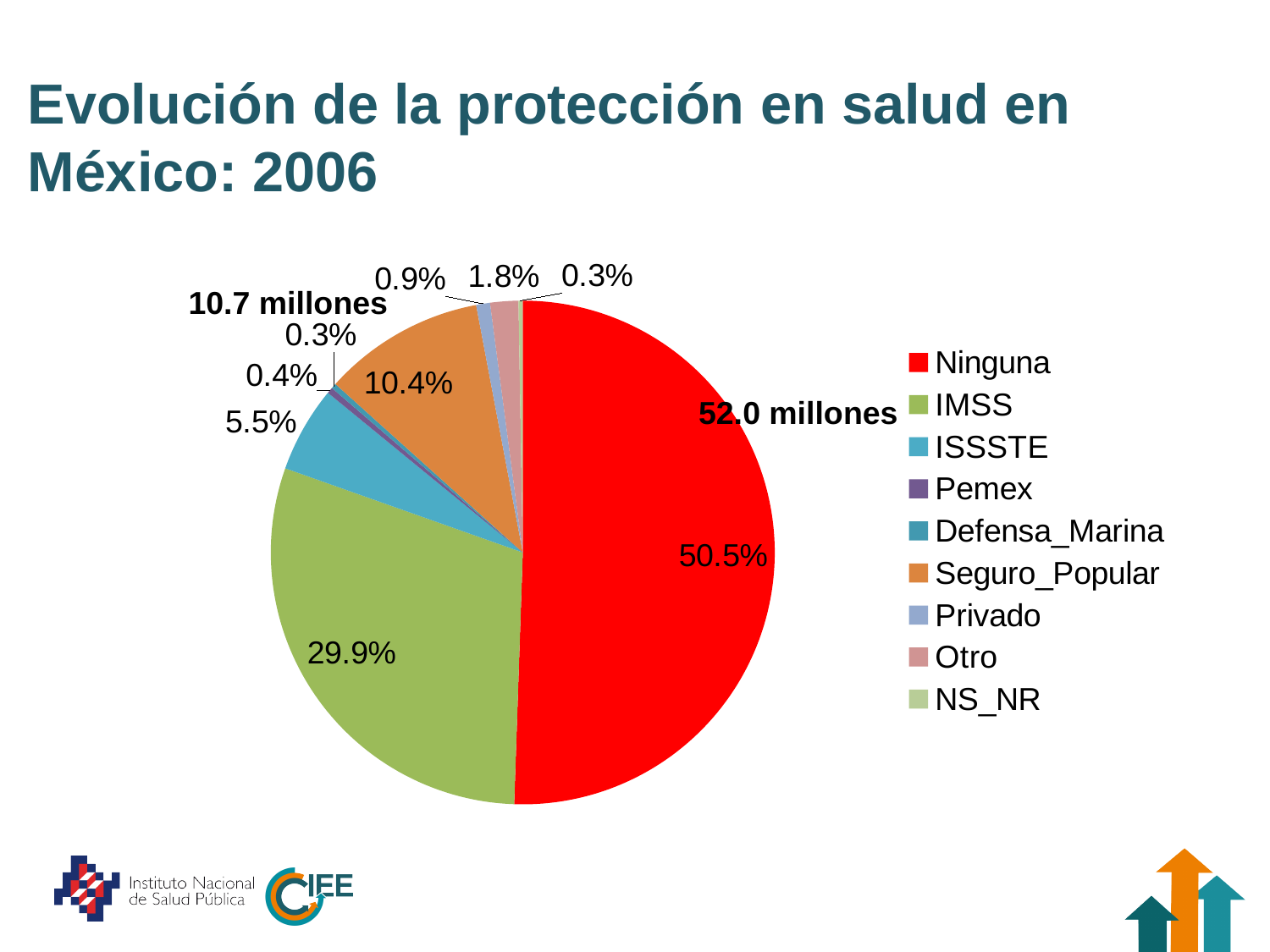
What share of the pie does Ninguna represent? 50.5% What colour is the Ninguna slice? red What share of the pie does IMSS represent? 29.9% What is the value shown for Seguro_Popular? 10.4% How many millions of people are annotated for the Ninguna slice? 52.0 millones What kind of chart is shown on the slide? pie chart What is the value shown for ISSSTE? 5.5% How many categories does the legend list? 9 What is the value shown for Otro? 1.8% Which is larger, the share for Seguro_Popular or the share for ISSSTE? Seguro_Popular What is the difference between the shares of Ninguna and IMSS? 20.6% Which category has the largest slice of the pie? Ninguna